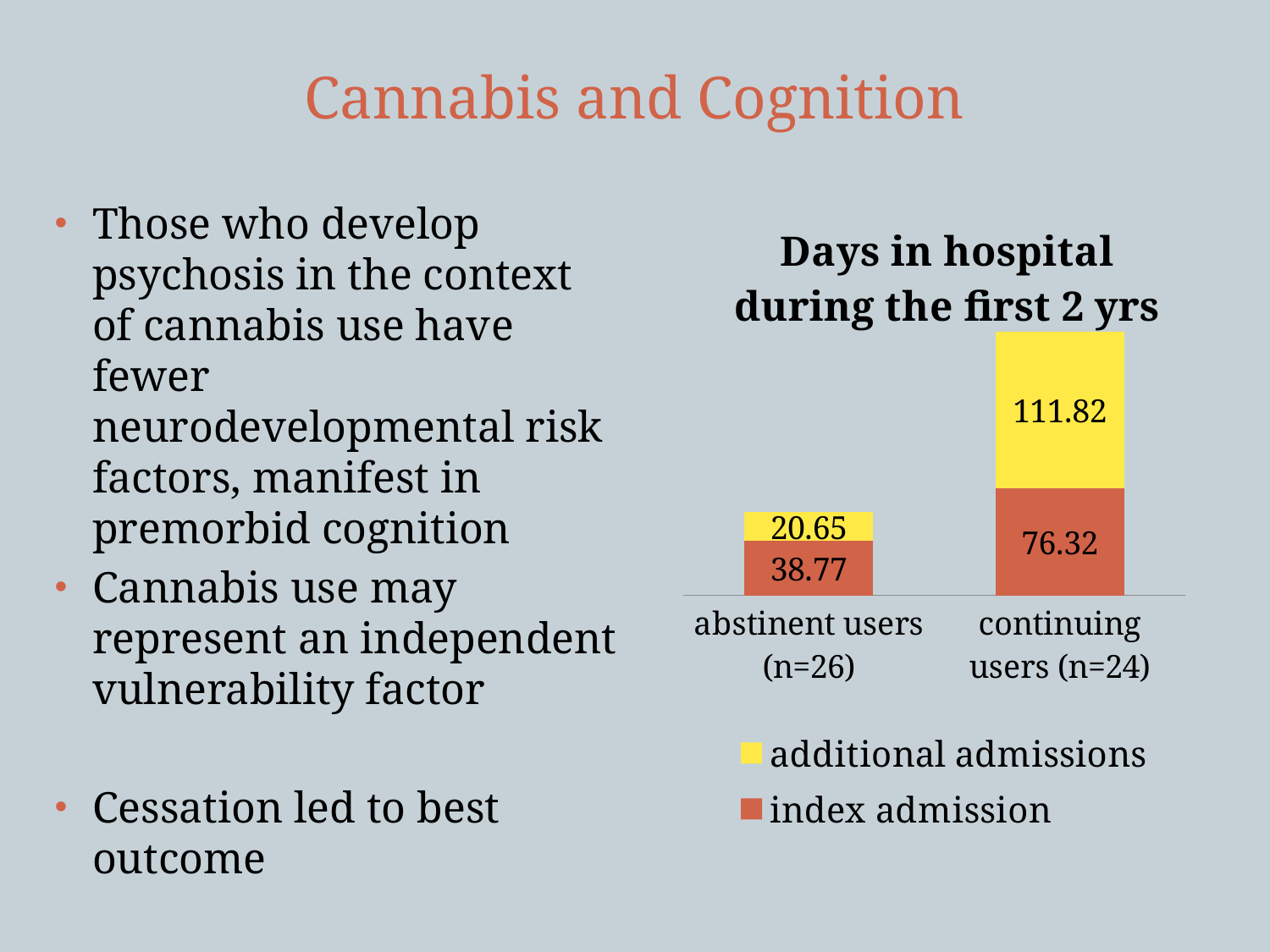
What is the total days in hospital for abstinent users (n=26), summing both segments of the stacked bar? 59.42 What is the index admission value for abstinent users (n=26)? 38.77 What is the difference between the index admission values for continuing users (n=24) and abstinent users (n=26)? 37.55 What is the additional admissions value for abstinent users (n=26)? 20.65 Which category has the lower additional admissions value? abstinent users (n=26) How many series does the legend list? 2 What is the index admission value for continuing users (n=24)? 76.32 What type of chart is shown on the slide? stacked bar chart What is the additional admissions value for continuing users (n=24)? 111.82 What is the total days in hospital for continuing users (n=24), summing both segments of the stacked bar? 188.14 Which category has the higher index admission value? continuing users (n=24) Is the additional admissions value larger for abstinent users (n=26) or continuing users (n=24)? continuing users (n=24)